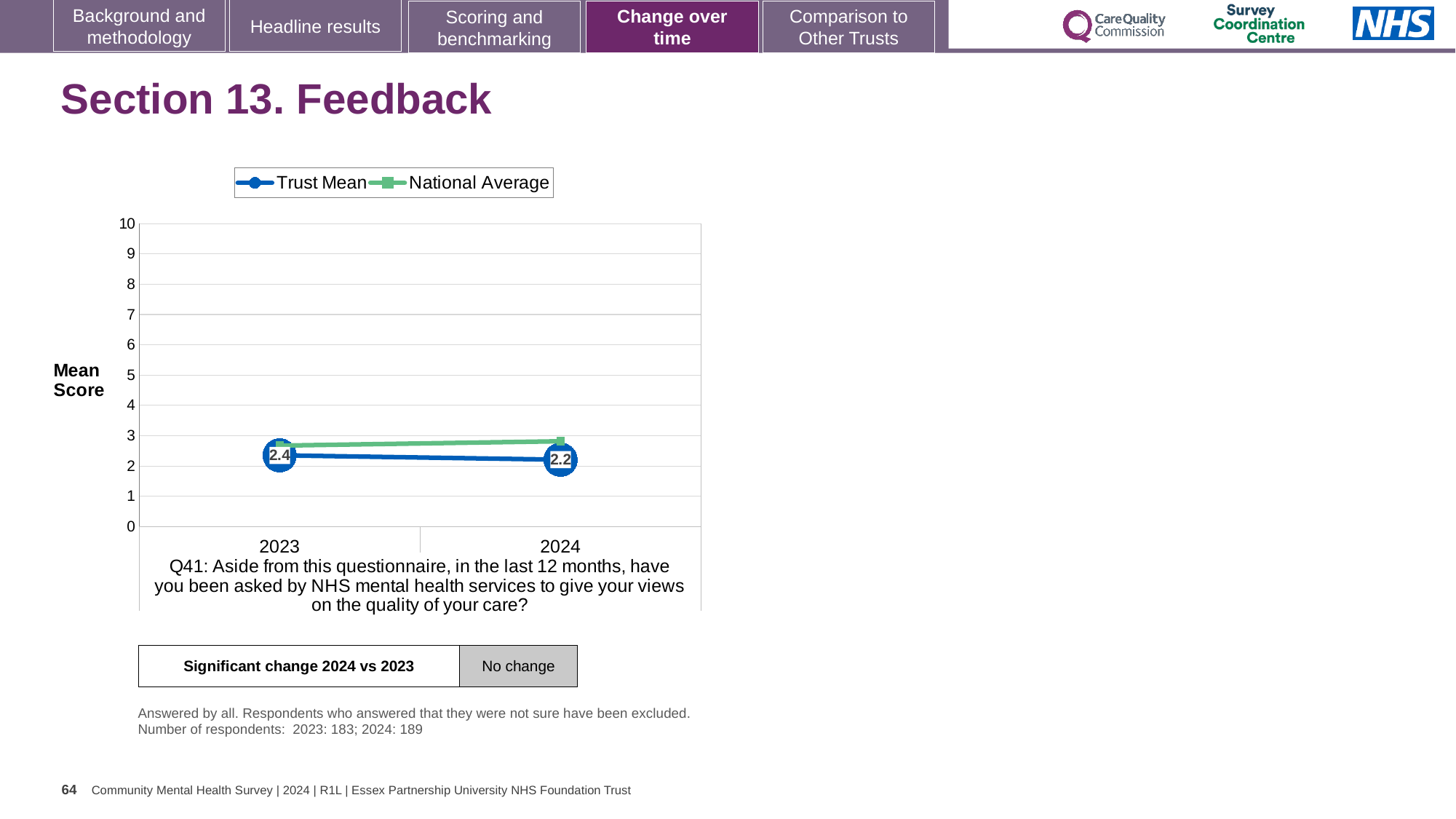
In 2024, which is higher: the Trust Mean or the National Average? National Average Does the Trust Mean rise or fall from 2023 to 2024? fall Which year has the higher Trust Mean, 2023 or 2024? 2023 Is the Trust Mean value for 2023 greater or less than 3? less What is the Trust Mean value for 2023? 2.4 By how much did the Trust Mean change from 2023 to 2024? 0.2 What is the Trust Mean value for 2024? 2.2 What is the label on the vertical axis of the chart? Mean Score What kind of chart is shown on the slide? line chart How many series does the legend list? 2 Is the National Average value for 2024 greater or less than 5? less How many years are plotted on the x axis? 2